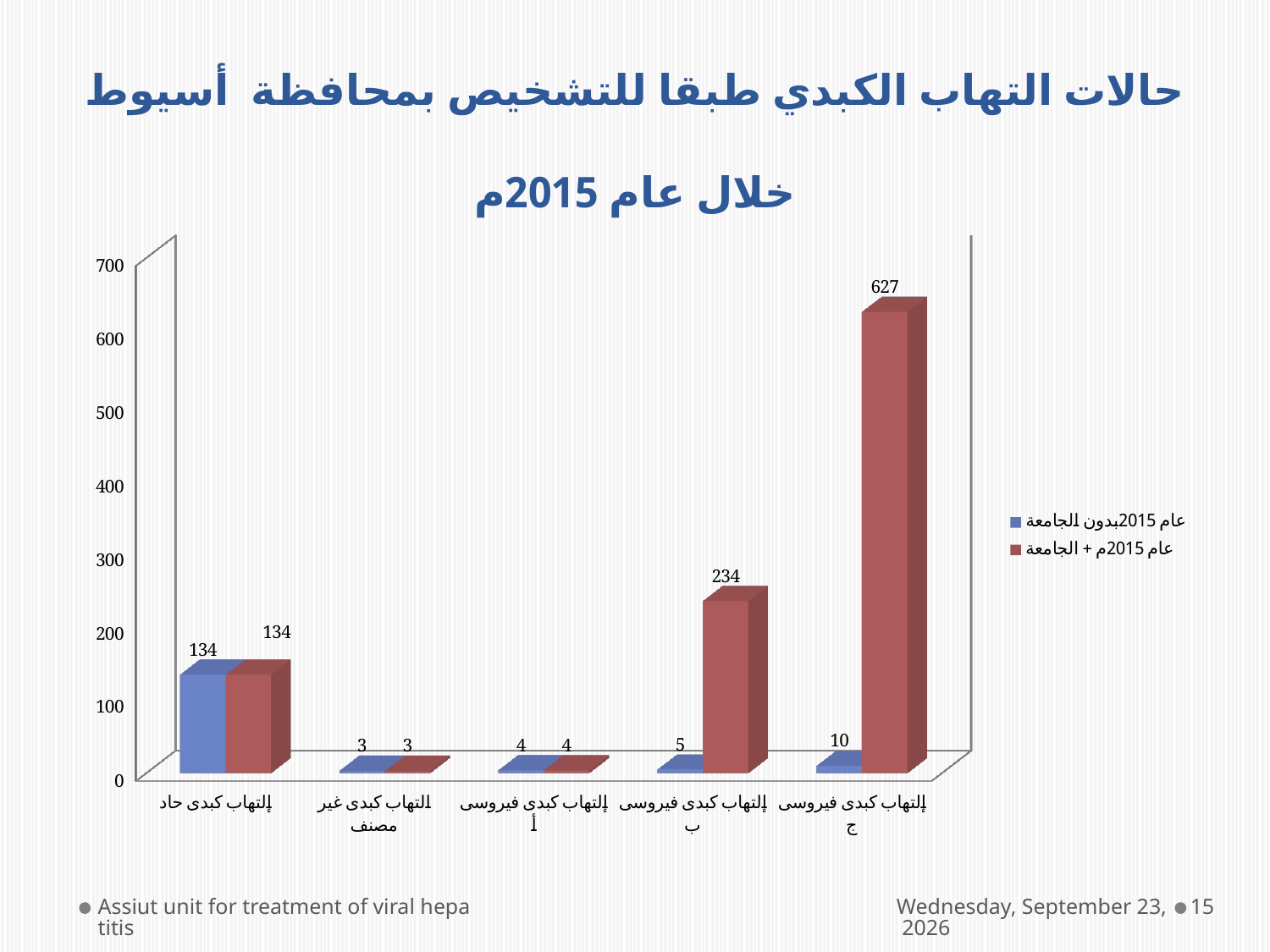
What colour are the bars for the series عام 2015م + الجامعة? Red How many categories are shown on the x axis? 5 Which category has the lowest value in the series عام 2015بدون الجامعة? التهاب كبدى غير مصنف What is the difference between the two series' values for إلتهاب كبدى فيروسى ب? 229 What is the value for إلتهاب كبدى فيروسى ج in the series عام 2015م + الجامعة? 627 How many series does the legend list? 2 Which is larger: the value for إلتهاب كبدى فيروسى ج in عام 2015م + الجامعة or the value for إلتهاب كبدى فيروسى ب in عام 2015م + الجامعة? إلتهاب كبدى فيروسى ج Is the value for إلتهاب كبدى فيروسى ج in the series عام 2015م + الجامعة greater or less than 600? greater Which category has the highest value in the series عام 2015م + الجامعة? إلتهاب كبدى فيروسى ج What type of chart is shown on the slide? Bar chart What is the value for إلتهاب كبدى حاد in the series عام 2015بدون الجامعة? 134 What is the value for إلتهاب كبدى فيروسى ب in the series عام 2015بدون الجامعة? 5